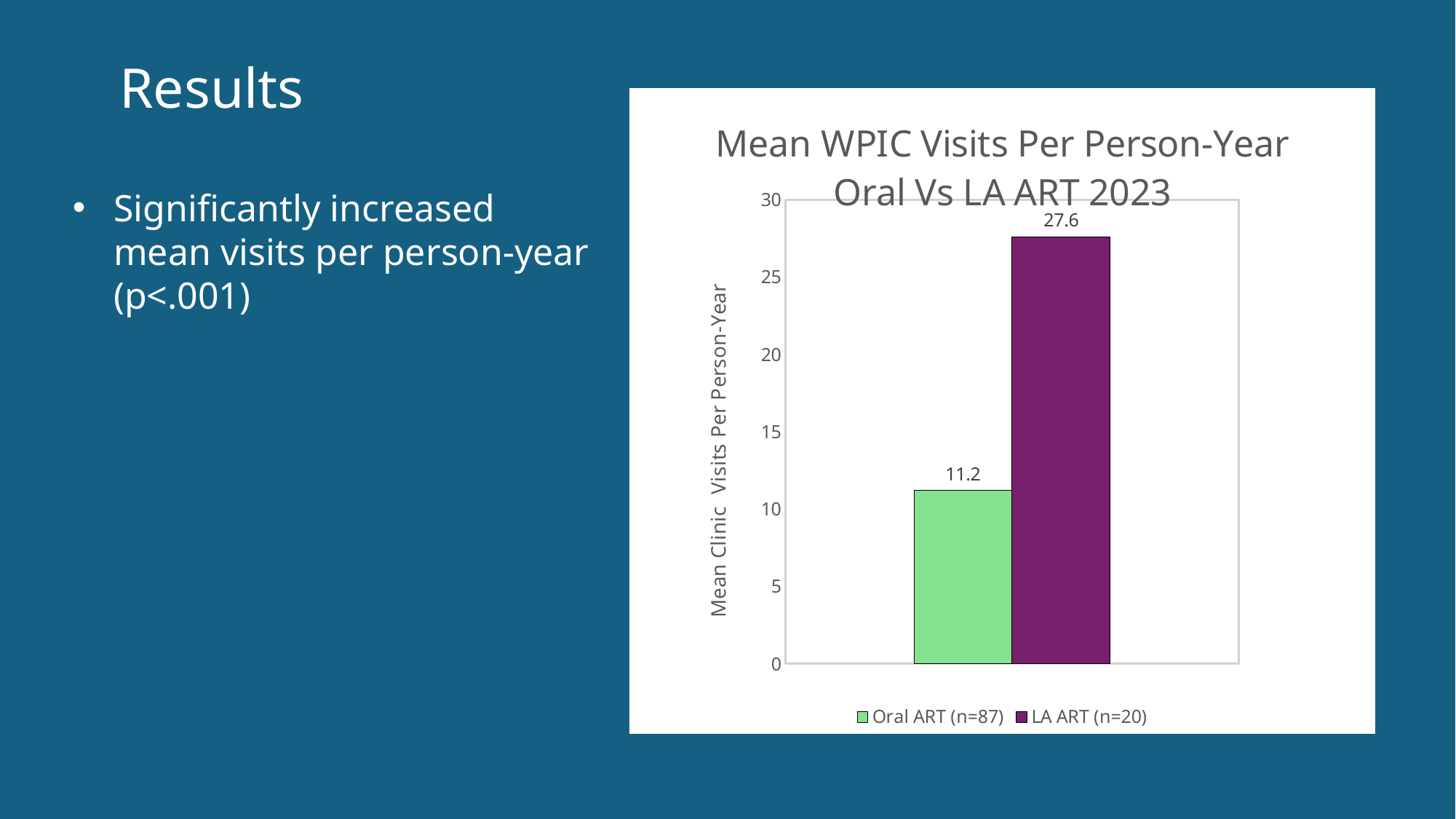
Is the value for Oral ART greater or less than 15? less How many series does the legend list? 2 What kind of chart is shown on the slide? Bar chart What is the difference in mean visits per person-year between LA ART and Oral ART? 16.4 Which group has the higher mean visits per person-year? LA ART (n=20) What is the mean WPIC visits per person-year for Oral ART (n=87)? 11.2 Is the value for Oral ART greater or less than the value for LA ART? less Which group has the lower mean visits per person-year? Oral ART (n=87) Is the value for LA ART greater or less than 25? greater What is the mean WPIC visits per person-year for LA ART (n=20)? 27.6 What is the label of the vertical axis of the chart? Mean Clinic Visits Per Person-Year How many bars are plotted in the chart? 2